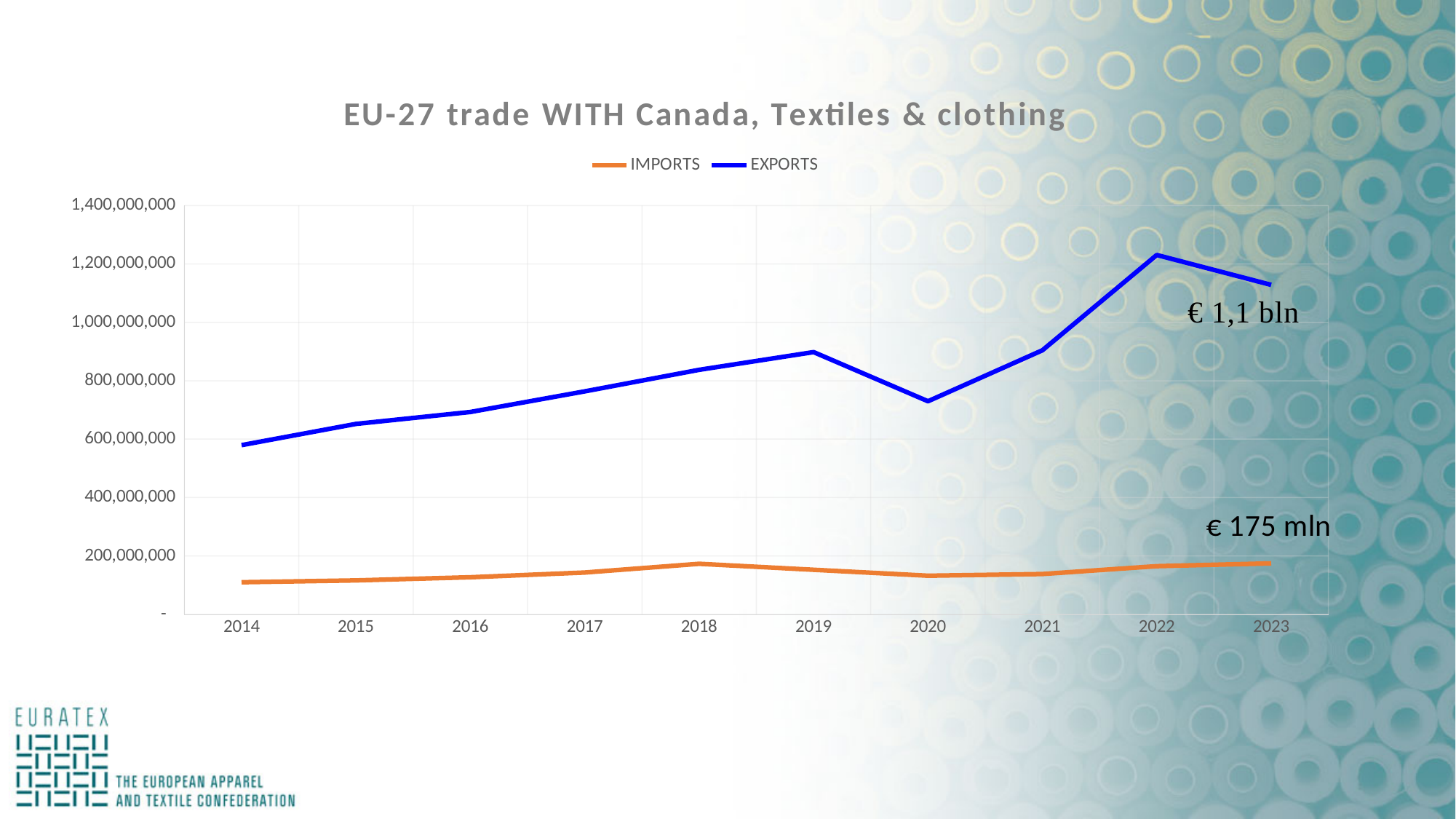
What value is annotated next to the EXPORTS line at 2023? € 1,1 bln How many series does the legend list? 2 Is the EXPORTS value for 2020 greater or less than 800,000,000? less In which year is the EXPORTS line at its highest? 2022 Is the EXPORTS value for 2022 greater or less than 1,000,000,000? greater Is the IMPORTS value for 2018 greater or less than 200,000,000? less Do EXPORTS rise or fall from 2014 to 2019? rise What kind of chart is shown on the slide? line chart What is the title of the chart? EU-27 trade WITH Canada, Textiles & clothing How many years are shown on the x axis? 10 In which year is the EXPORTS line at its lowest? 2014 Which series is higher in 2020, IMPORTS or EXPORTS? EXPORTS